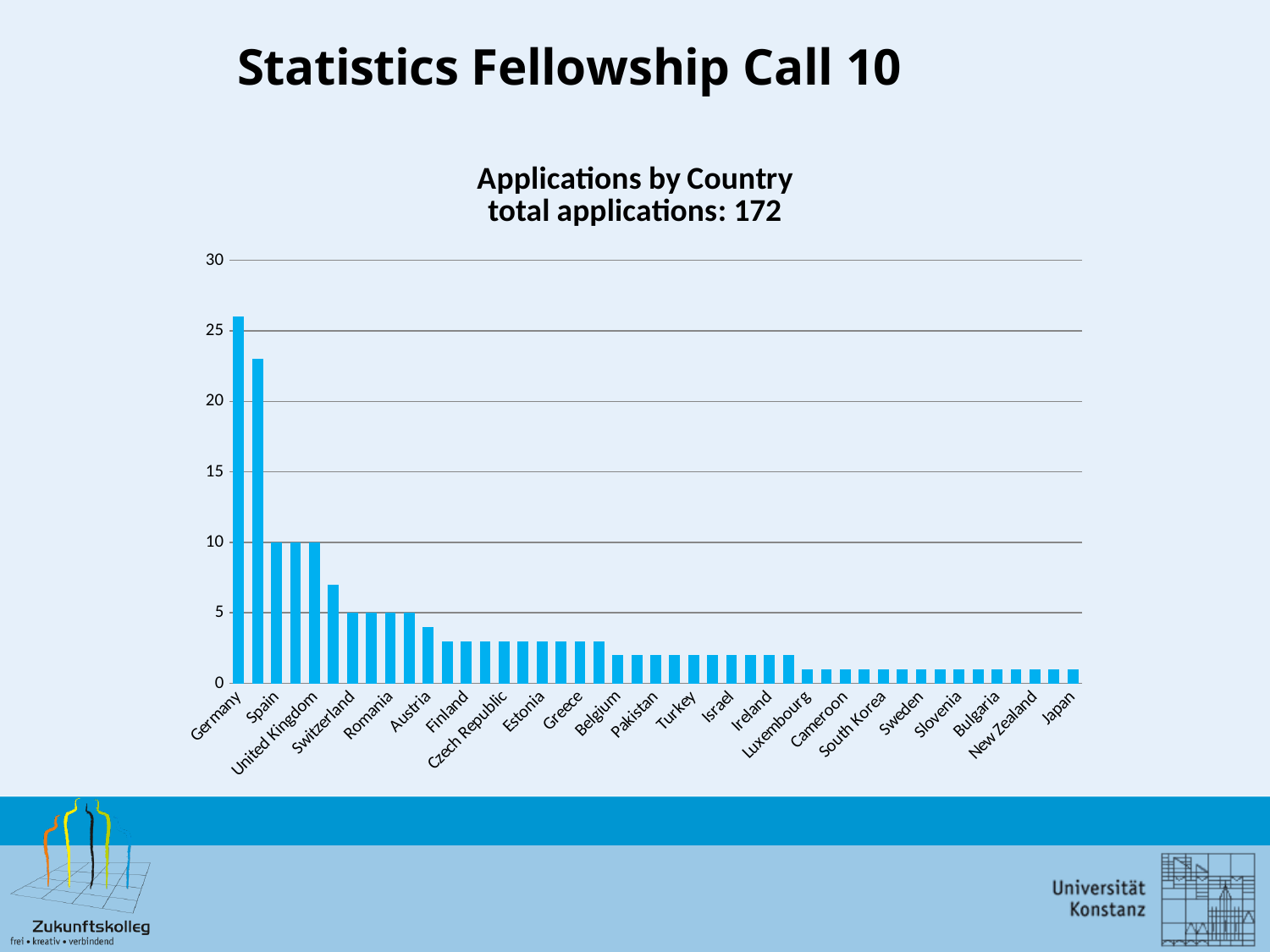
How many applications came from Spain? 10 How many applications came from the United Kingdom? 10 What total number of applications does the chart subtitle state? 172 Is the value for Japan greater or less than 5? less Do the values rise or fall moving from left to right along the x axis? fall Which country has the highest number of applications? Germany What is the title of the chart? Applications by Country How many applications came from Switzerland? 5 What is the difference between the values for Spain and Switzerland? 5 Is the value for Germany greater or less than 25? greater Which has more applications, Germany or Spain? Germany What kind of chart is shown on the slide? bar chart